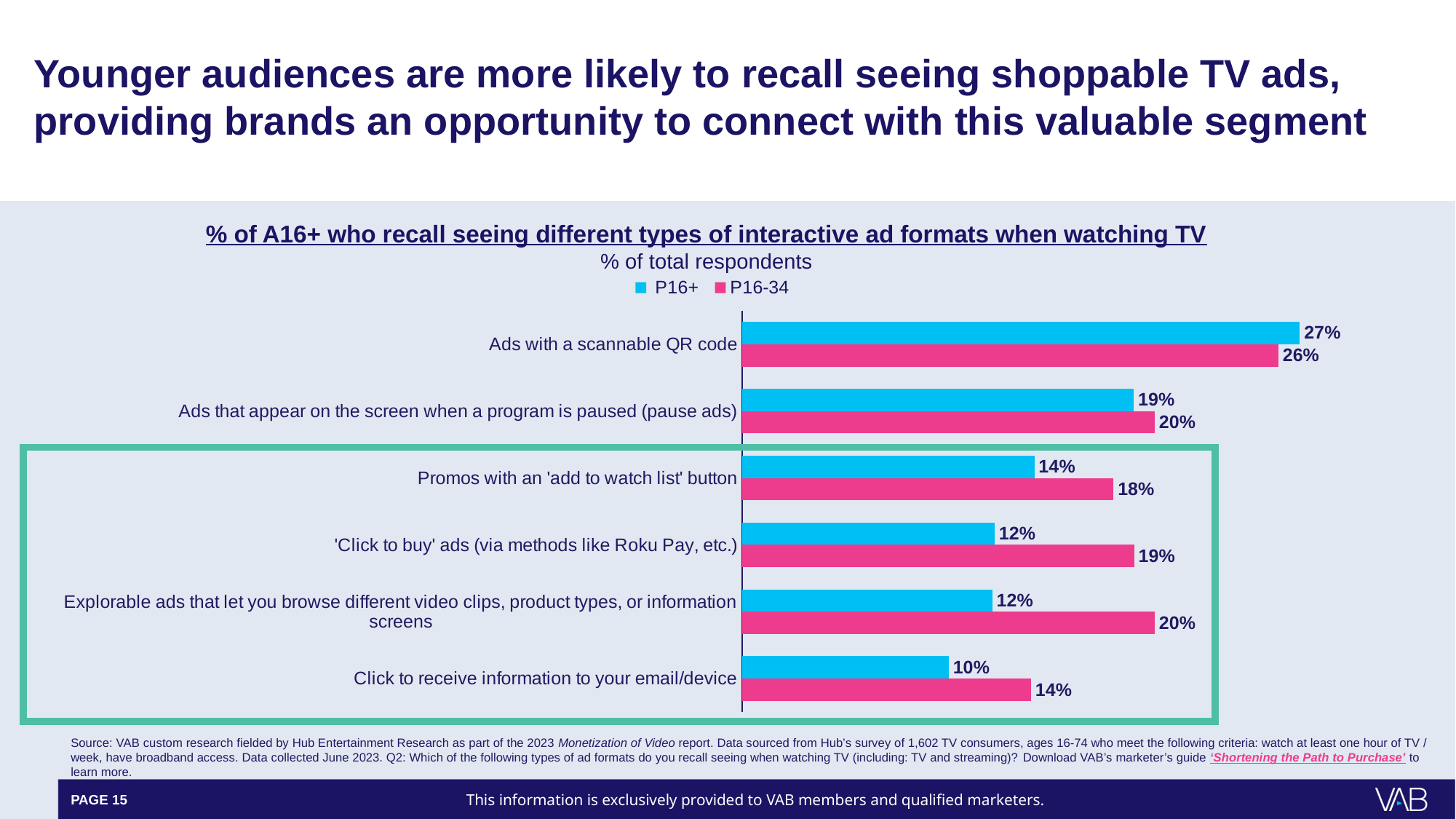
Which colour represents the P16-34 series in the chart? Pink What is the P16-34 value for 'Click to receive information to your email/device'? 14% What type of chart is shown on the slide? Bar chart How many series does the legend list? 2 What percentage of P16+ recall seeing ads with a scannable QR code? 27% What is the difference between the P16+ and P16-34 values for ads with a scannable QR code? 1% What percentage of P16-34 recall seeing 'Click to buy' ads (via methods like Roku Pay, etc.)? 19% How many ad format categories are shown in the chart? 6 What is the difference between the P16-34 and P16+ values for 'Click to buy' ads? 7% Which ad format has the highest recall among P16+? Ads with a scannable QR code For 'Promos with an 'add to watch list' button', which group has the higher value, P16+ or P16-34? P16-34 Which ad format has the lowest recall among P16-34? Click to receive information to your email/device